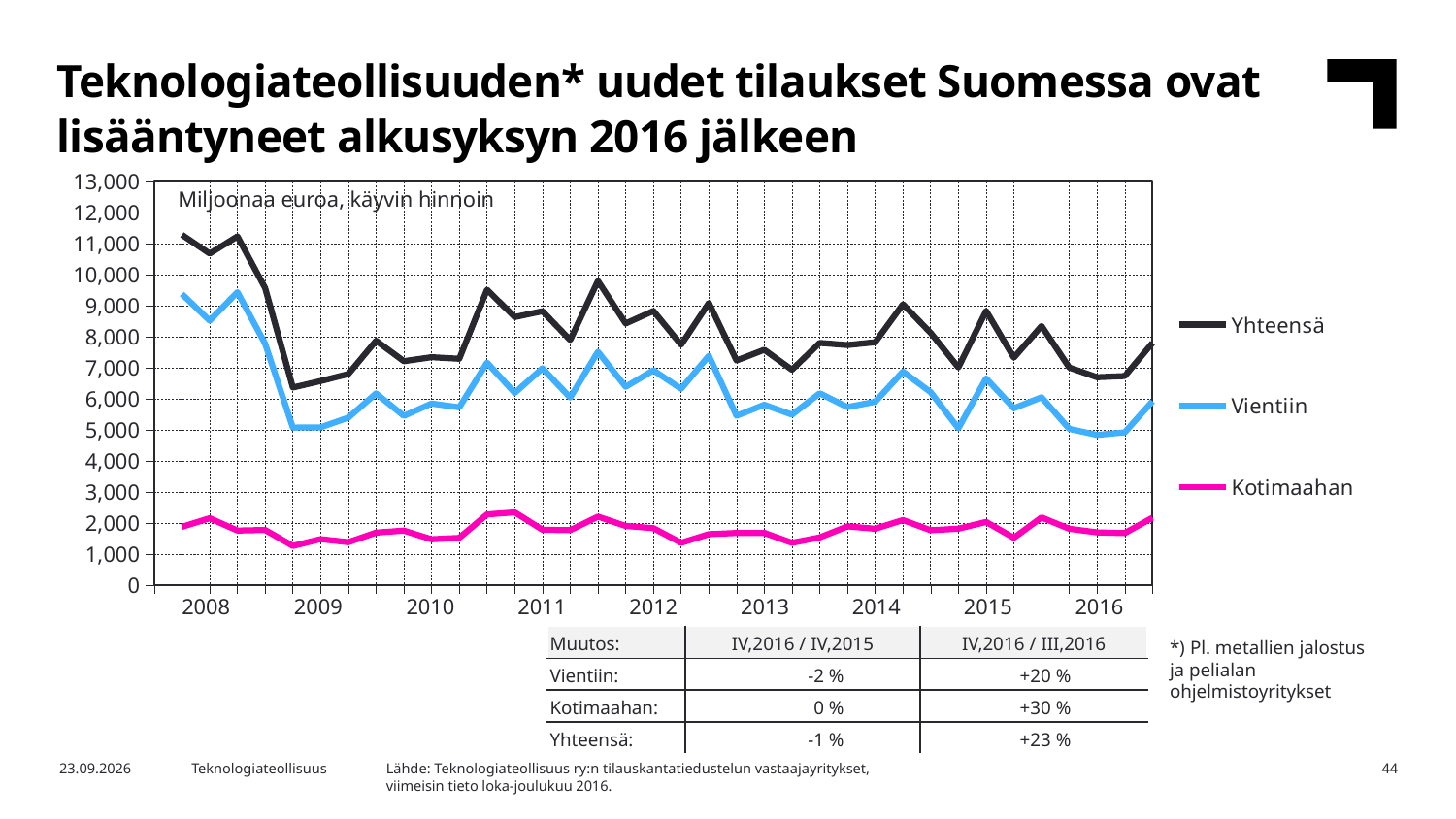
Is the value for Kotimaahan at the end of 2016 greater or less than 3,000? less Does the Yhteensä series overall rise or fall from 2008 to 2016? fall How many years are labelled on the x axis? 9 Is the value for Vientiin at the end of 2016 greater or less than 5,000? greater Which series has the highest values throughout the chart? Yhteensä Which series are listed in the legend? Yhteensä, Vientiin, Kotimaahan Which series has the lowest values throughout the chart? Kotimaahan Is the value for Yhteensä at the start of 2008 greater or less than 10,000? greater What unit label is printed inside the chart area? Miljoonaa euroa, käyvin hinnoin How many series does the legend list? 3 What kind of chart is shown on the slide? line chart At the end of 2016, which is larger, Vientiin or Kotimaahan? Vientiin